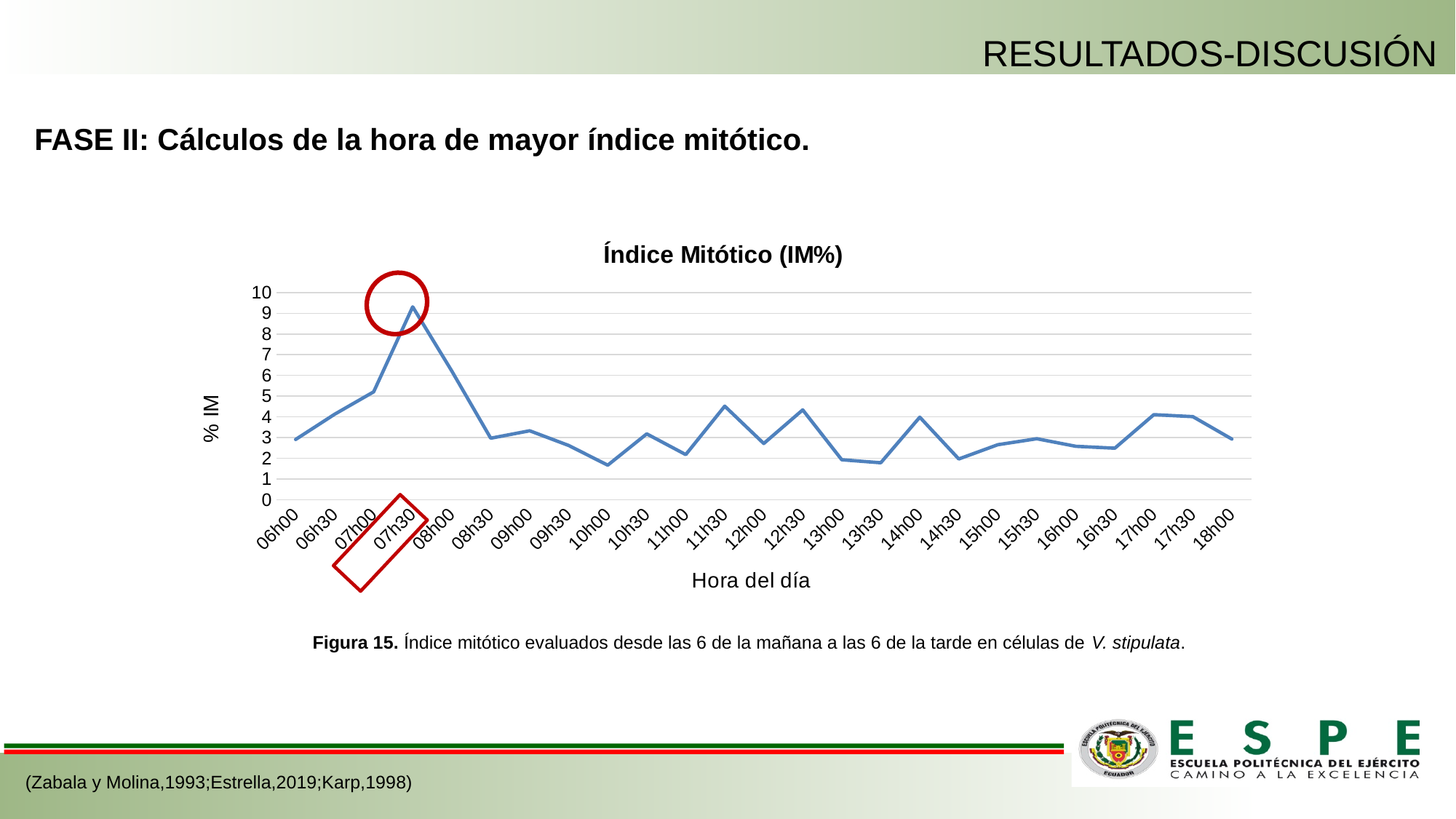
What kind of chart is shown on the slide? Line chart Is the value for 07h00 greater or less than 4? greater At which time of day is the mitotic index highest? 07h30 Is the value for 10h00 greater or less than 2? less Is the value for 07h30 greater or less than 8? greater What is the title of the chart? Índice Mitótico (IM%) Which has the higher value, 11h30 or 10h00? 11h30 How many time points are plotted on the x axis? 25 What is the label of the x axis of the chart? Hora del día Which has the higher value, 07h30 or 08h00? 07h30 Do the values rise or fall from 06h00 to 07h30? rise